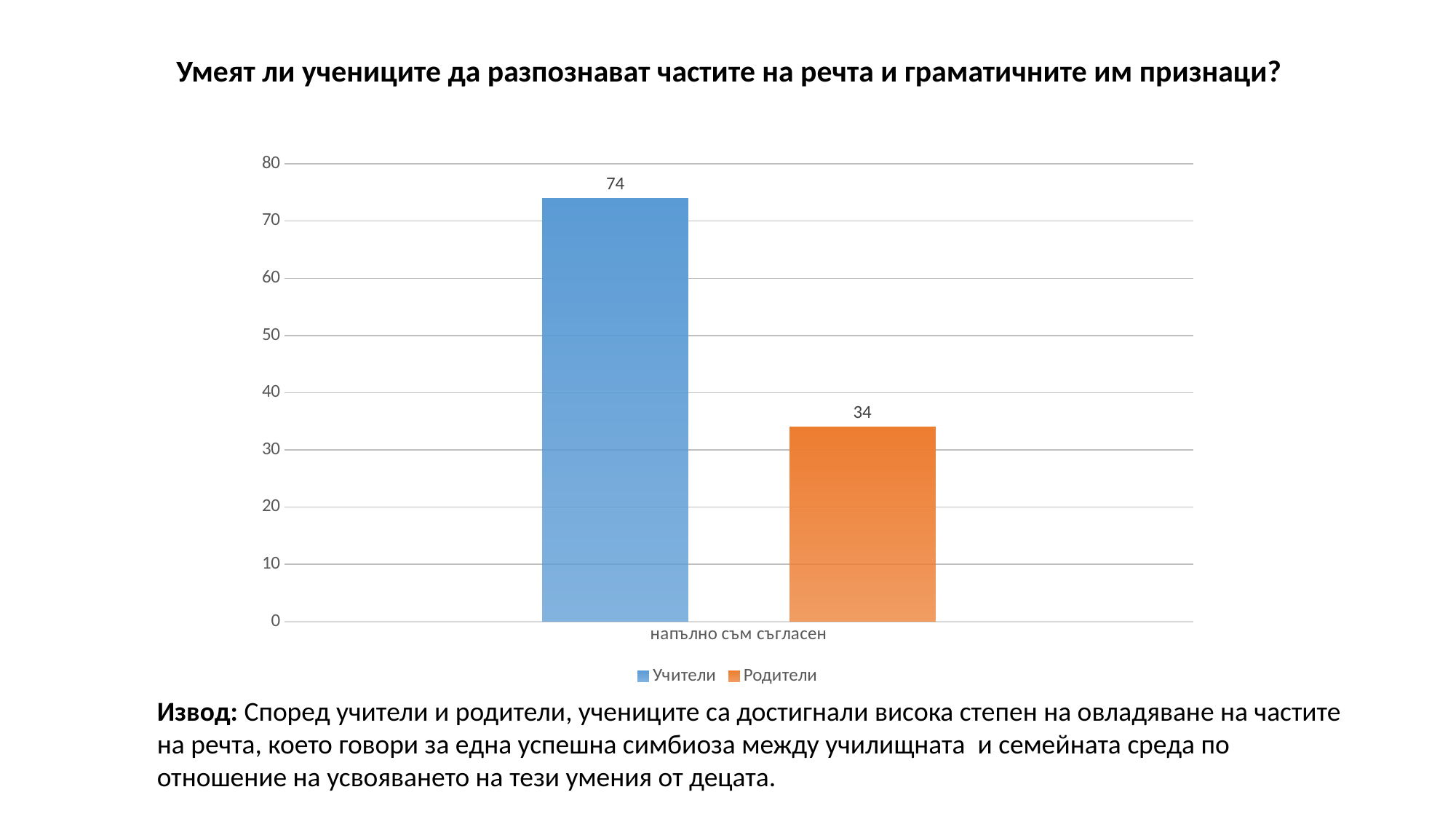
What colour is the bar for Родители? orange Which series has the lowest value? Родители How many categories are shown on the x axis? 1 What is the difference between the values for Учители and Родители? 40 What kind of chart is shown on the slide? bar chart Is the value for Родители greater or less than 40? less What is the category label on the x axis? напълно съм съгласен What is the value for Родители? 34 Is the value for Учители greater or less than 70? greater What is the value for Учители? 74 How many series does the legend list? 2 Which series has the higher value, Учители or Родители? Учители